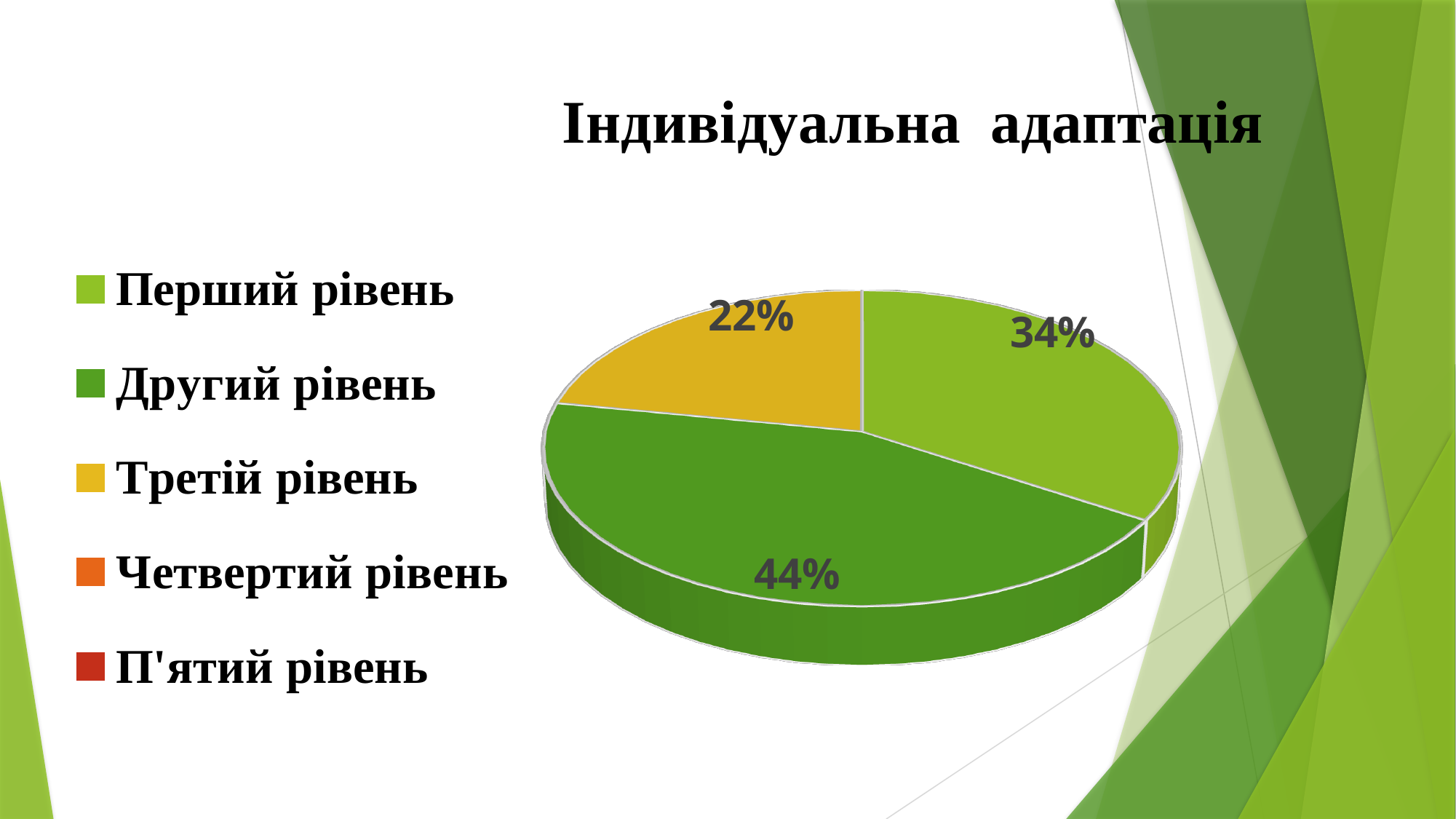
What is the title of the chart? Індивідуальна адаптація What percentage does the slice for Другий рівень show? 44% Which is larger, the slice for Перший рівень or the slice for Третій рівень? Перший рівень Of the three slices with percentage labels, which is the smallest? Третій рівень What percentage does the slice for Третій рівень show? 22% What is the difference in percentage points between Другий рівень and Перший рівень? 10 Which level has the largest slice of the pie? Другий рівень What is the difference in percentage points between Перший рівень and Третій рівень? 12 How many slices of the pie have a percentage label? 3 What percentage does the slice for Перший рівень show? 34% How many entries does the legend list? 5 What kind of chart is shown on the slide? Pie chart